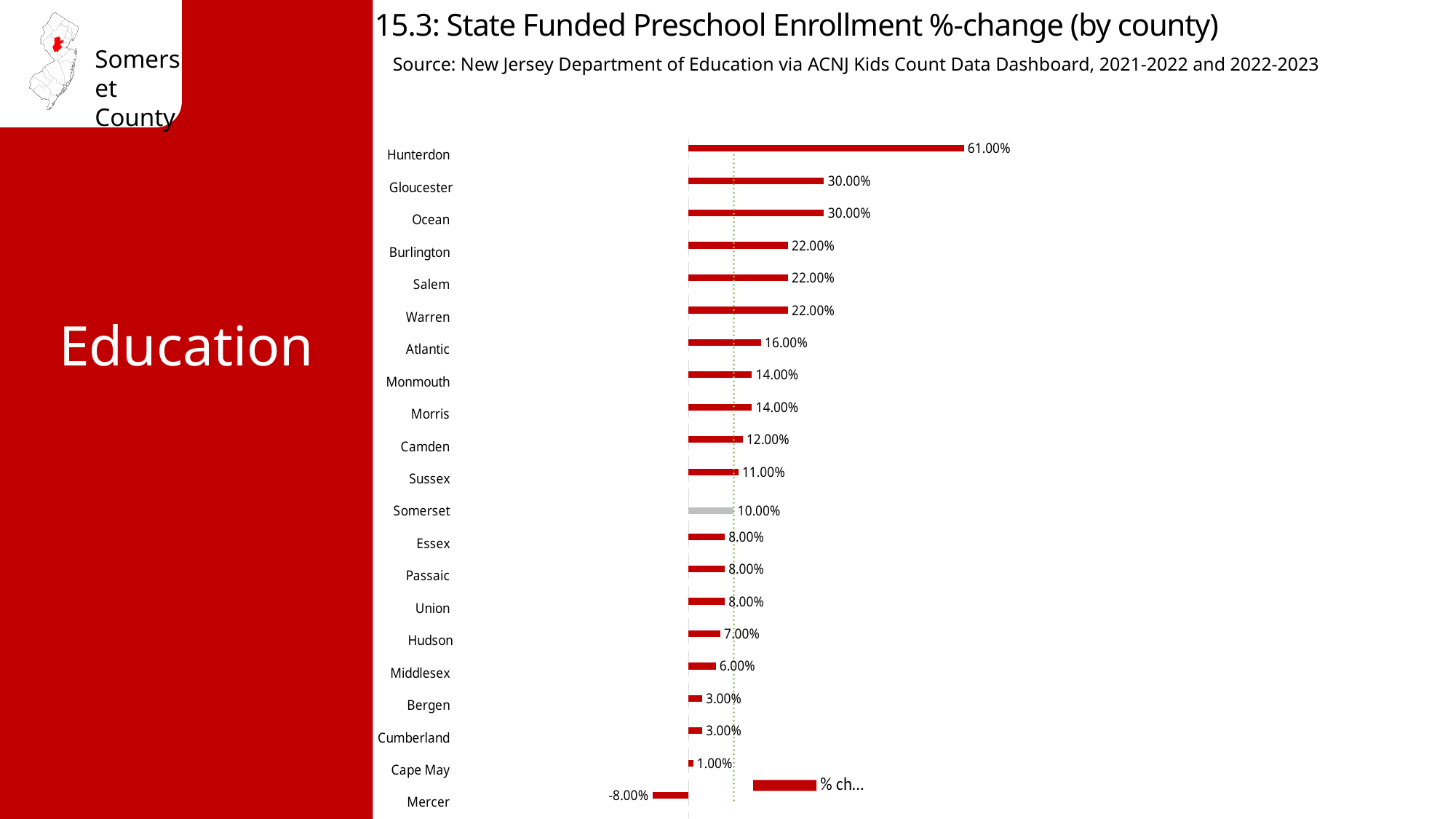
What is the value shown for Cape May? 1.00% Which county's bar is drawn in grey rather than red? Somerset Which county has the highest %-change? Hunterdon Which has a larger value, Atlantic or Camden? Atlantic What is the state funded preschool enrollment %-change for Hunterdon? 61.00% How many counties are shown on the chart? 21 What is the difference between the values for Hunterdon and Gloucester? 31.00% What is the difference between the values for Somerset and Mercer? 18.00% What kind of chart is shown on the slide? Bar chart What is the value shown for Mercer? -8.00% What is the value shown for Somerset? 10.00% Which county has the lowest %-change? Mercer